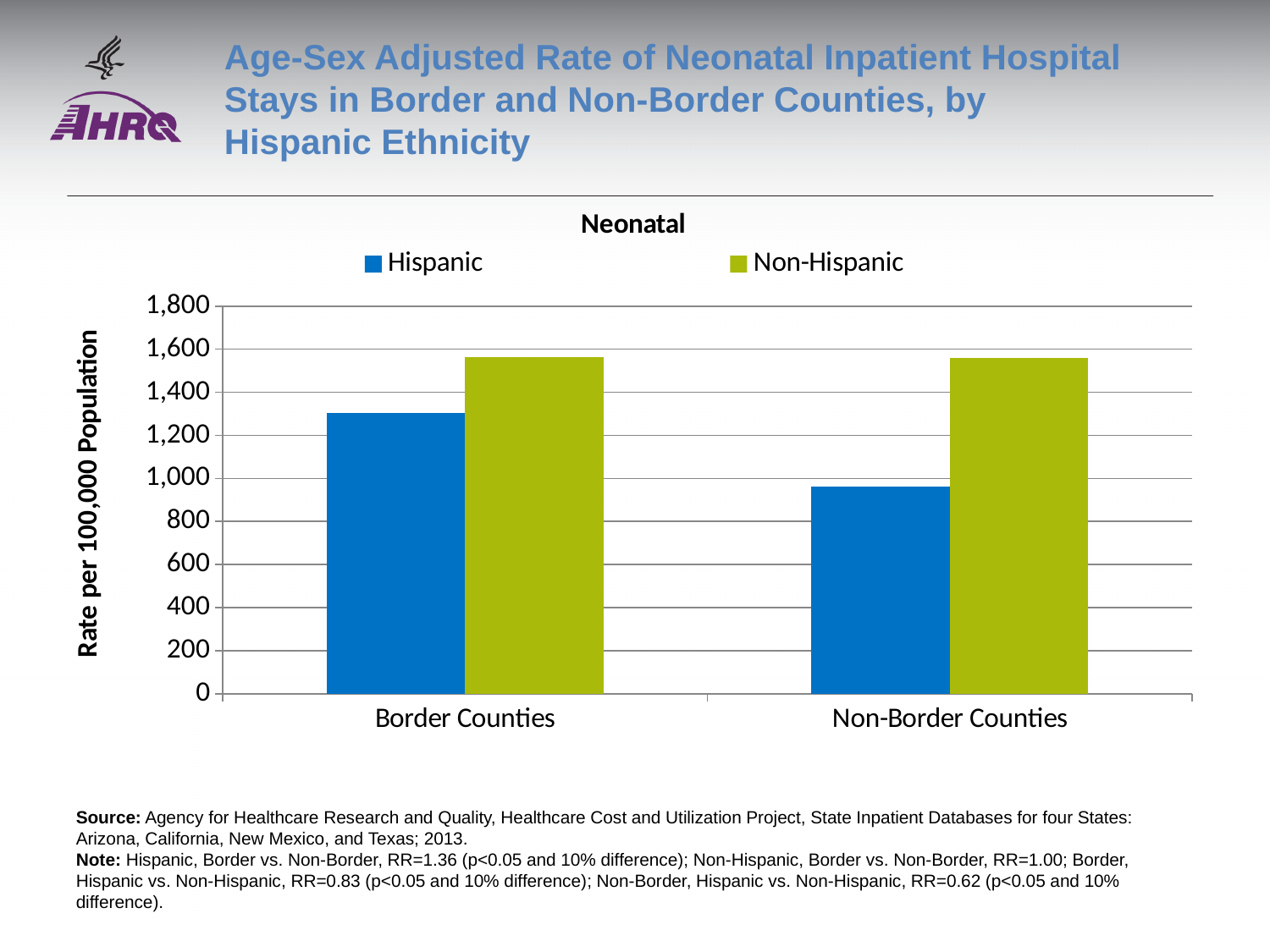
In Border Counties, which is larger, the Hispanic or the Non-Hispanic value? Non-Hispanic How many series does the legend list? 2 Is the value for Hispanic in Border Counties greater or less than 1,200? greater Is the value for Hispanic in Non-Border Counties greater or less than 1,000? less Which series is shown in blue? Hispanic Is the value for Non-Hispanic in Border Counties greater or less than 1,400? greater What type of chart is shown on the slide? bar chart For the Hispanic series, which category has the lower value? Non-Border Counties How many categories are shown on the x axis? 2 What is the title of the chart? Neonatal Which bar is the lowest on the chart? Hispanic, Non-Border Counties